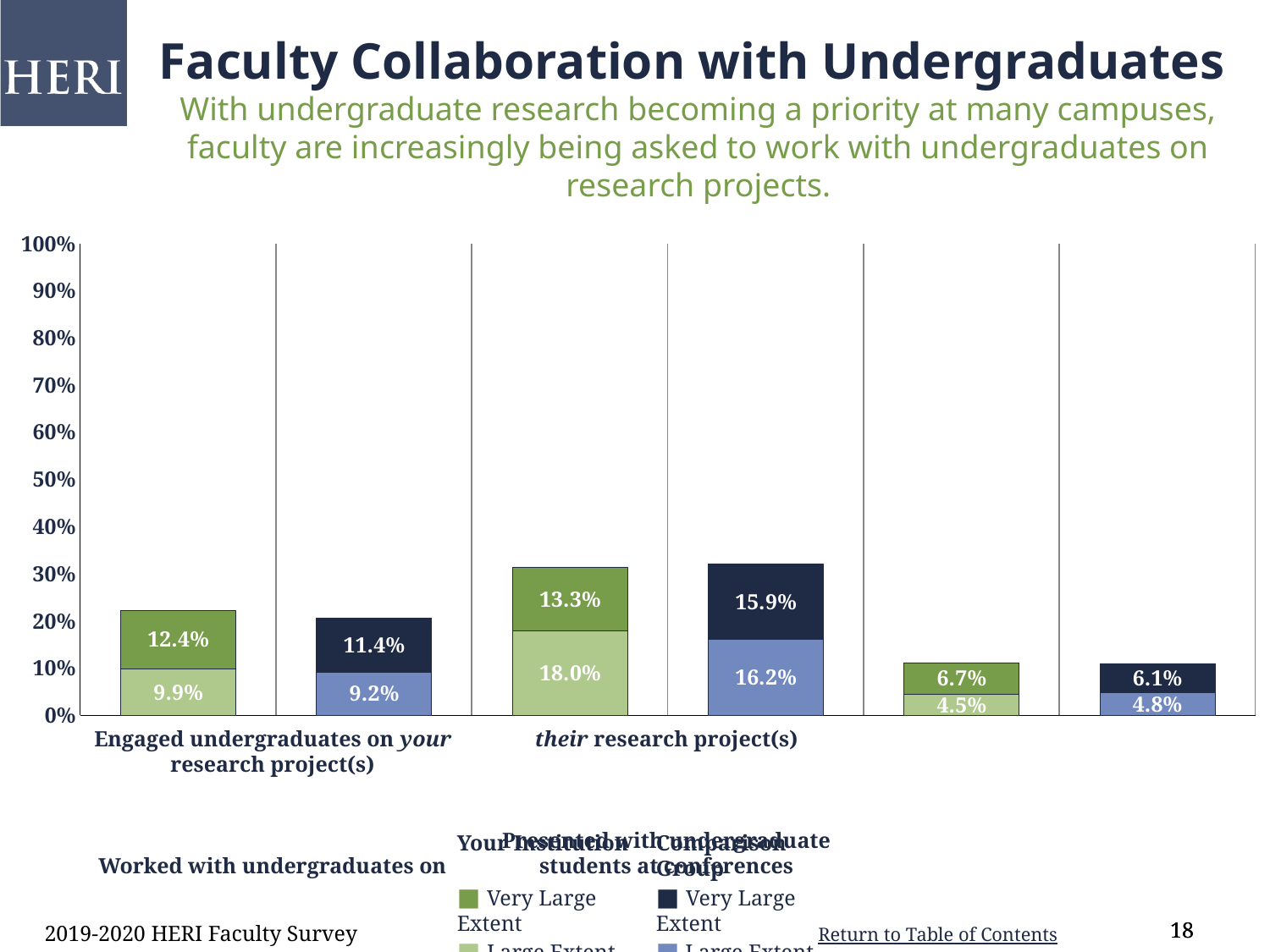
What is the Large Extent value for Your Institution for 'Worked with undergraduates on their research project(s)'? 18.0% What is the Large Extent value for the Comparison Group for 'Engaged undergraduates on your research project(s)'? 9.2% Is the total stacked bar for Your Institution for 'Worked with undergraduates on their research project(s)' greater or less than 30%? greater What is the Very Large Extent value for the Comparison Group for 'Worked with undergraduates on their research project(s)'? 15.9% Which activity has the tallest stacked bars overall? Worked with undergraduates on their research project(s) What is the total stacked value (Very Large Extent plus Large Extent) for Your Institution for 'Engaged undergraduates on your research project(s)'? 22.3% What percentage of faculty at Your Institution engaged undergraduates on their own research project(s) to a Very Large Extent? 12.4% What type of chart is shown on the slide? Stacked bar chart What is the total stacked value for the Comparison Group for 'Worked with undergraduates on their research project(s)'? 32.1% What is the difference between the Very Large Extent values for Your Institution and the Comparison Group for 'Engaged undergraduates on your research project(s)'? 1.0% For 'Worked with undergraduates on their research project(s)', which has the larger Large Extent value: Your Institution or the Comparison Group? Your Institution What is the maximum value shown on the vertical axis? 100%